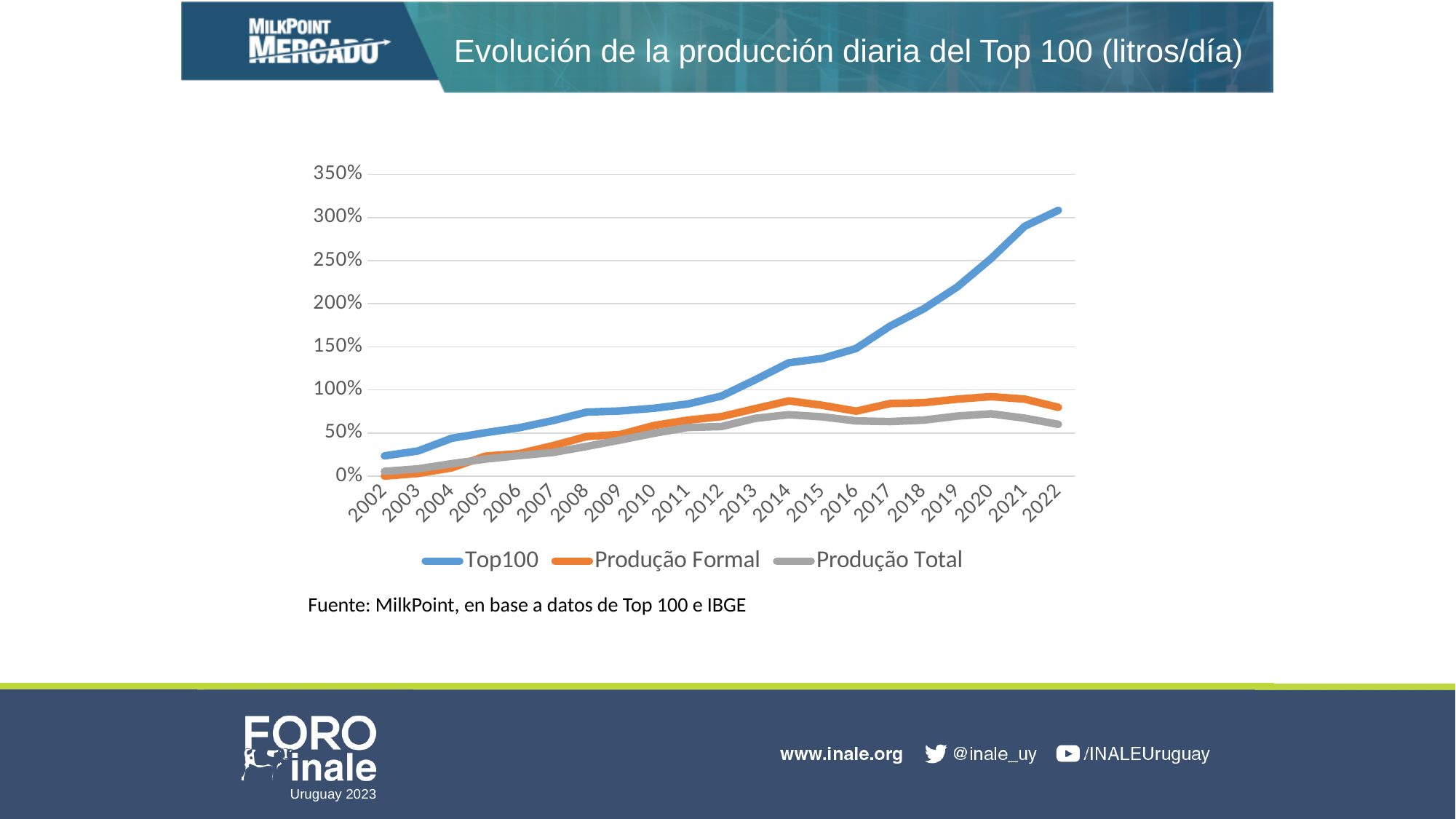
How many years are shown on the x axis? 21 How many series does the legend list? 3 Is the value for Produção Formal in 2022 greater or less than 100%? less Which series has the lowest value in 2022? Produção Total Is the value for Top100 in 2022 greater or less than 250%? greater Does the Top100 series generally rise or fall from 2002 to 2022? rise What colour is the Top100 line in the legend? blue Is the value for Top100 in 2014 greater or less than 100%? greater What kind of chart is shown on the slide? line chart In 2022, which is larger: Top100 or Produção Formal? Top100 Which series has the highest value in 2022? Top100